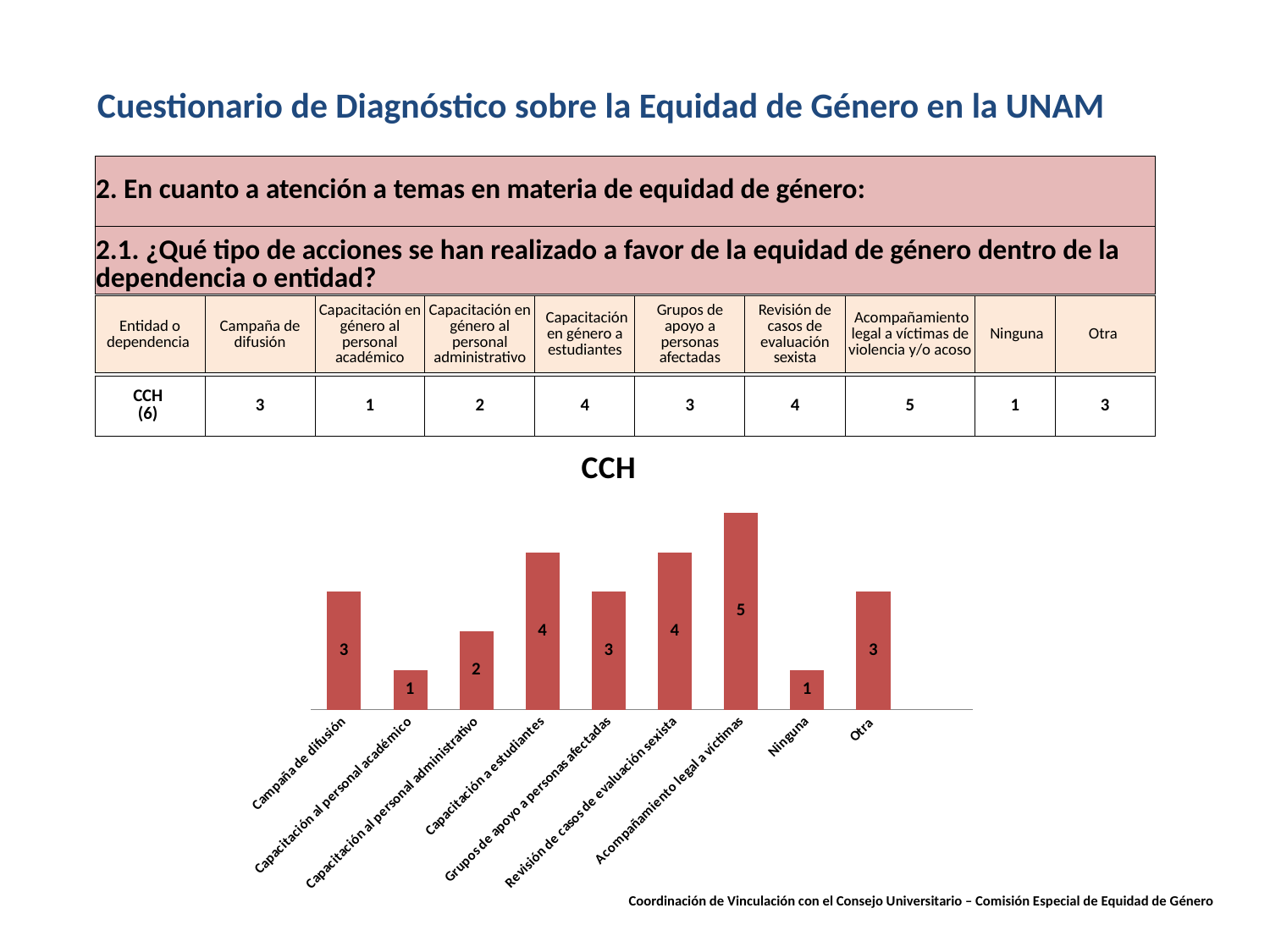
Which is larger, the value for Capacitación al personal administrativo or the value for Ninguna? Capacitación al personal administrativo What is the difference between the values for Acompañamiento legal a víctimas and Capacitación al personal académico? 4 What is the value for Ninguna? 1 Which category has the highest value? Acompañamiento legal a víctimas What is the difference between the values for Revisión de casos de evaluación sexista and Grupos de apoyo a personas afectadas? 1 What is the title of the chart? CCH What is the value for Campaña de difusión? 3 What type of chart is shown on the slide? bar chart What is the value for Capacitación al personal administrativo? 2 Which is larger, the value for Capacitación a estudiantes or the value for Otra? Capacitación a estudiantes How many categories are plotted in the chart? 9 What is the value for Acompañamiento legal a víctimas? 5